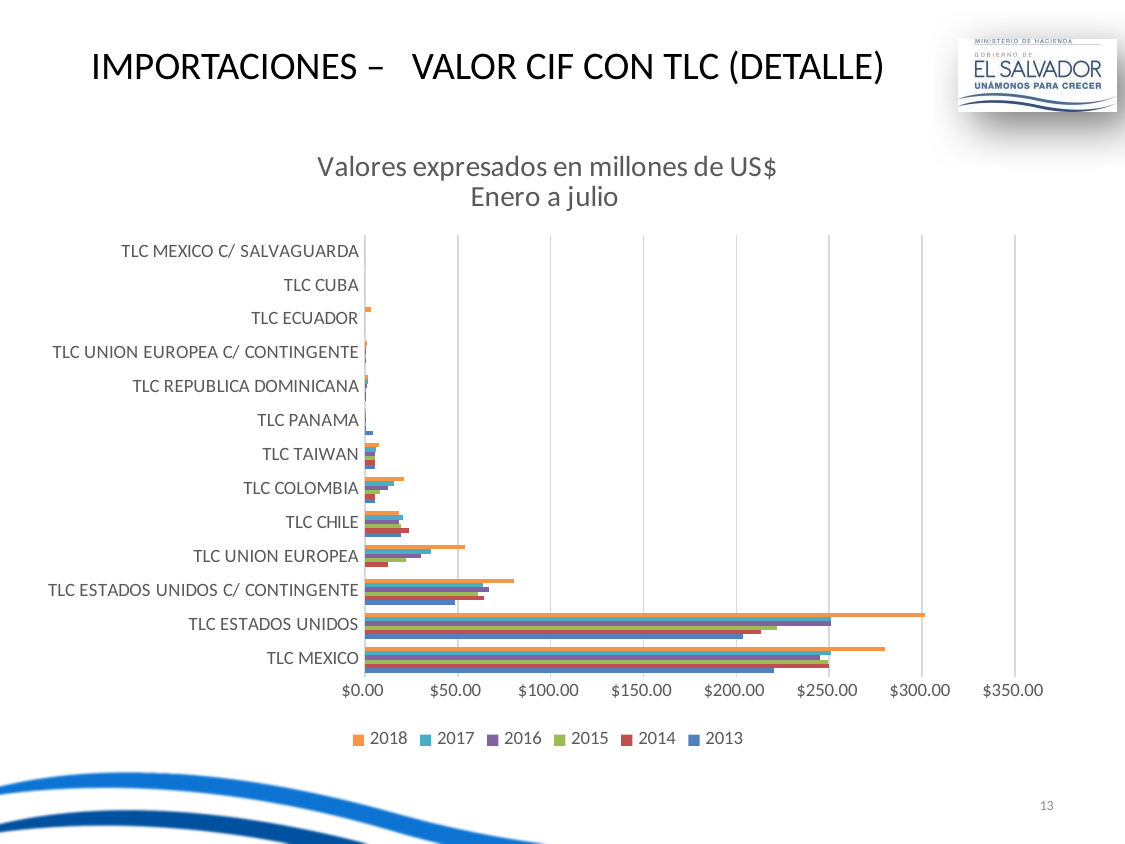
Which is larger in 2018: TLC ESTADOS UNIDOS or TLC MEXICO? TLC ESTADOS UNIDOS How many series does the legend list? 6 Is the 2018 value for TLC ESTADOS UNIDOS C/ CONTINGENTE greater or less than $50.00? greater Is the 2018 value for TLC CHILE greater or less than $50.00? less How many TLC categories are plotted on the chart? 13 Is the 2018 value for TLC MEXICO greater or less than $250.00? greater Which year is listed first in the legend? 2018 What kind of chart is shown on the slide? bar chart Which is larger in 2018: TLC UNION EUROPEA or TLC CHILE? TLC UNION EUROPEA Which category has the highest 2018 value? TLC ESTADOS UNIDOS What is the title shown above the chart? Valores expresados en millones de US$ Enero a julio